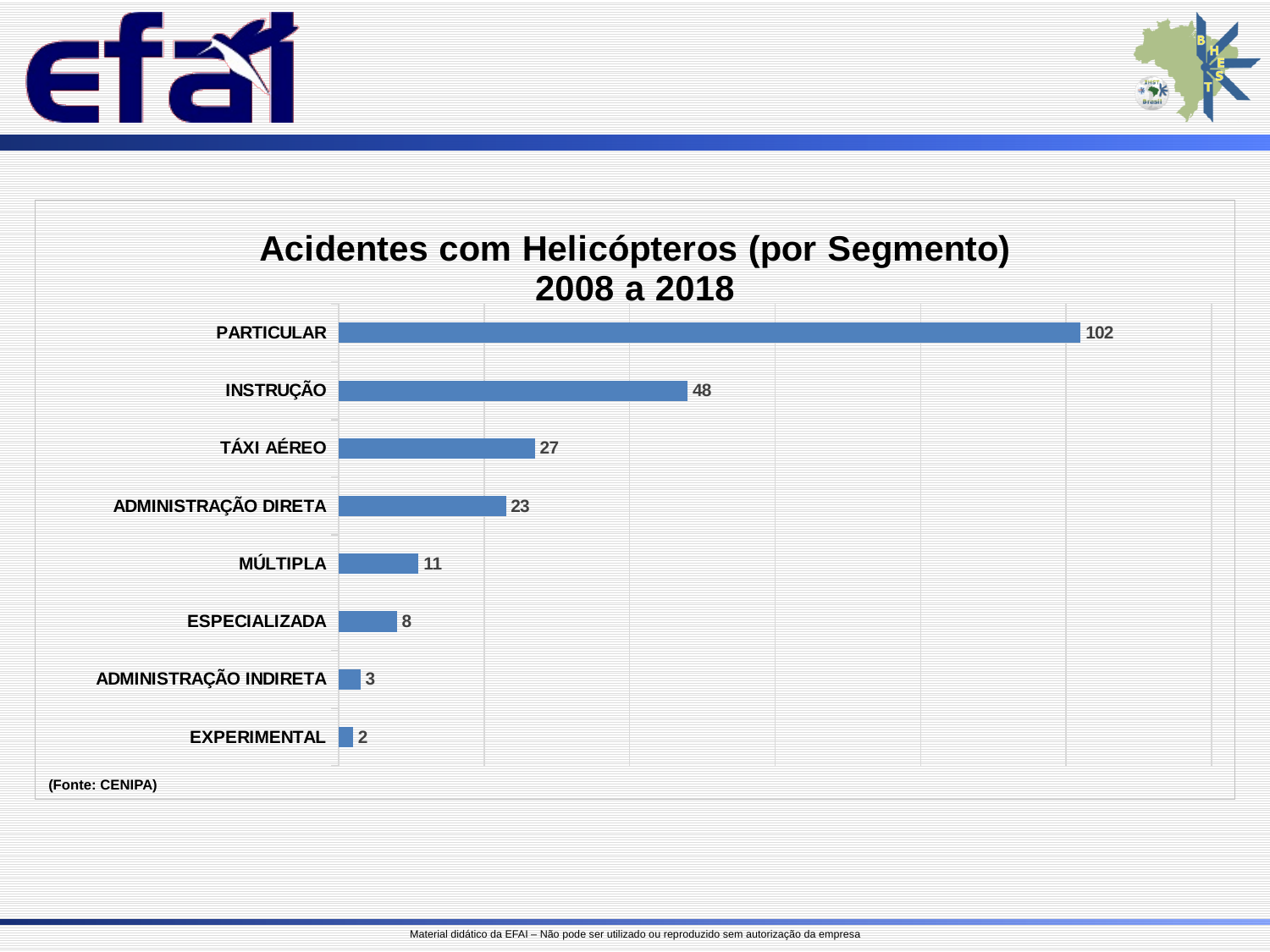
Which segment has the lowest number of accidents? EXPERIMENTAL How many segments are shown in the chart? 8 Which segment has the highest number of accidents? PARTICULAR What is the value for ADMINISTRAÇÃO INDIRETA? 3 What is the difference between the values for PARTICULAR and INSTRUÇÃO? 54 What is the value for TÁXI AÉREO? 27 What is the title of the chart? Acidentes com Helicópteros (por Segmento) 2008 a 2018 What kind of chart is shown on the slide? Bar chart What source is cited for the chart data? CENIPA Which is larger, the value for MÚLTIPLA or the value for ESPECIALIZADA? MÚLTIPLA What is the value for PARTICULAR? 102 What is the difference between the values for TÁXI AÉREO and ADMINISTRAÇÃO DIRETA? 4